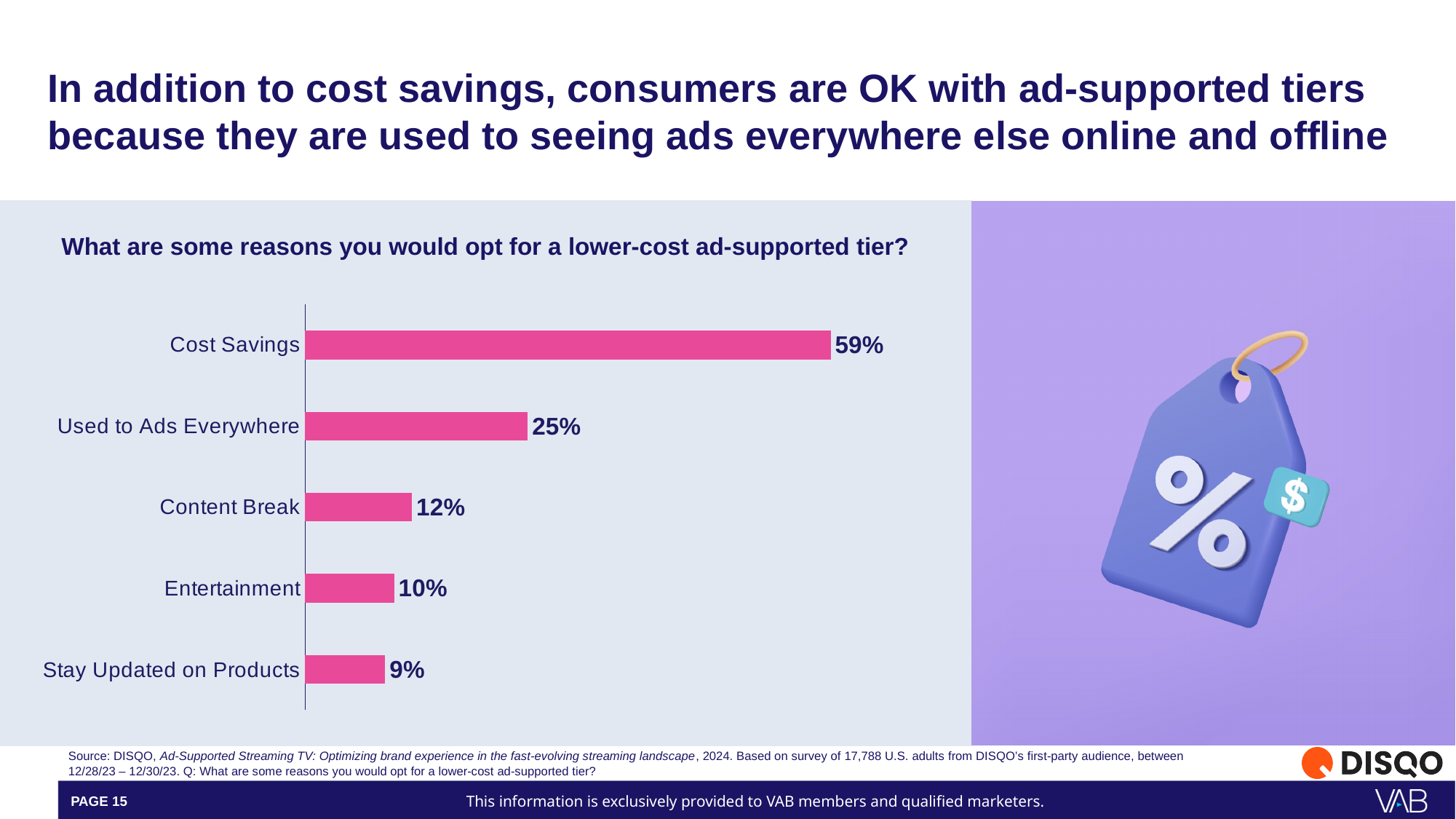
How many reasons are shown in the chart? 5 What is the value shown for Stay Updated on Products? 9% Which reason has the highest percentage? Cost Savings Which is larger, the value for Content Break or the value for Entertainment? Content Break What type of chart is shown on the slide? Bar chart Which reason has the lowest percentage? Stay Updated on Products What is the value shown for Content Break? 12% What question does the chart title ask? What are some reasons you would opt for a lower-cost ad-supported tier? What percentage of respondents cited Cost Savings as a reason to opt for a lower-cost ad-supported tier? 59% What is the difference in percentage points between Entertainment and Stay Updated on Products? 1 What is the difference in percentage points between Cost Savings and Used to Ads Everywhere? 34 What is the value shown for Used to Ads Everywhere? 25%